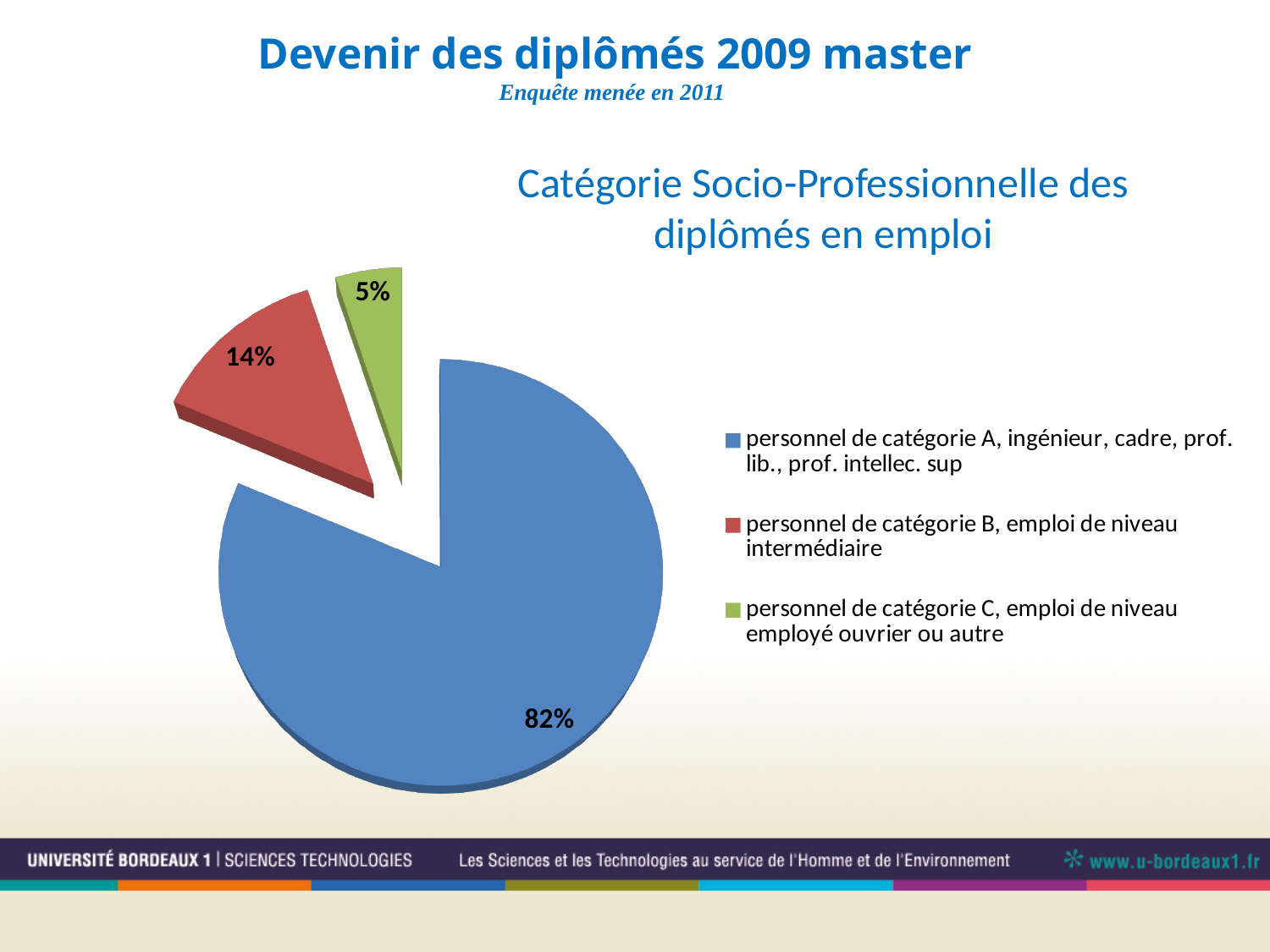
What share of the pie is 'personnel de catégorie A, ingénieur, cadre, prof. lib., prof. intellec. sup'? 82% What share of the pie is 'personnel de catégorie C, emploi de niveau employé ouvrier ou autre'? 5% What share of the pie is 'personnel de catégorie B, emploi de niveau intermédiaire'? 14% What is the difference in percentage points between the share for catégorie B and the share for catégorie C? 9 Which category has the smallest share of the pie? personnel de catégorie C, emploi de niveau employé ouvrier ou autre Which category has the largest share of the pie? personnel de catégorie A, ingénieur, cadre, prof. lib., prof. intellec. sup What is the title of the pie chart? Catégorie Socio-Professionnelle des diplômés en emploi What is the difference in percentage points between the share for catégorie A and the share for catégorie B? 68 What kind of chart is shown on the slide? pie chart How many slices does the pie chart have? 3 Which is larger, the share for catégorie B or the share for catégorie C? catégorie B What colour is the slice for 'personnel de catégorie C, emploi de niveau employé ouvrier ou autre'? green